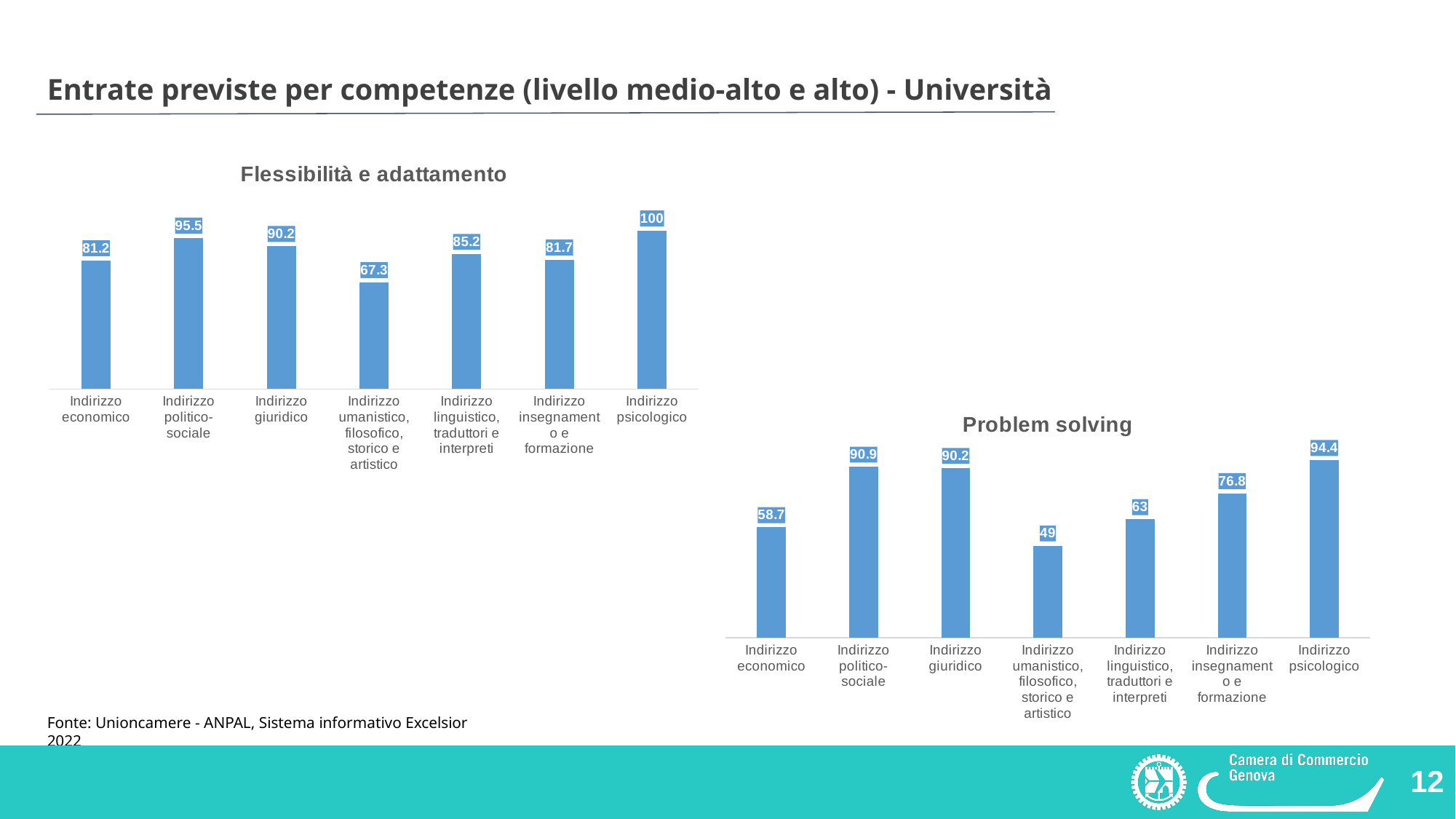
In the 'Problem solving' chart, which category has the lowest value? Indirizzo umanistico, filosofico, storico e artistico In the 'Problem solving' chart, what is the value for Indirizzo politico-sociale? 90.9 In the 'Flessibilità e adattamento' chart, which category has the highest value? Indirizzo psicologico What kind of chart is the 'Flessibilità e adattamento' chart? Bar chart In the 'Problem solving' chart, which is larger: Indirizzo linguistico, traduttori e interpreti or Indirizzo insegnamento e formazione? Indirizzo insegnamento e formazione In the 'Flessibilità e adattamento' chart, what is the value for Indirizzo giuridico? 90.2 In the 'Problem solving' chart, what is the difference between Indirizzo psicologico and Indirizzo economico? 35.7 How many categories are shown in the 'Problem solving' chart? 7 In the 'Flessibilità e adattamento' chart, what is the difference between Indirizzo politico-sociale and Indirizzo umanistico, filosofico, storico e artistico? 28.2 In the 'Flessibilità e adattamento' chart, which is larger: Indirizzo economico or Indirizzo linguistico, traduttori e interpreti? Indirizzo linguistico, traduttori e interpreti What is the title of the chart on the left of the slide? Flessibilità e adattamento In the 'Problem solving' chart, what is the value for Indirizzo insegnamento e formazione? 76.8